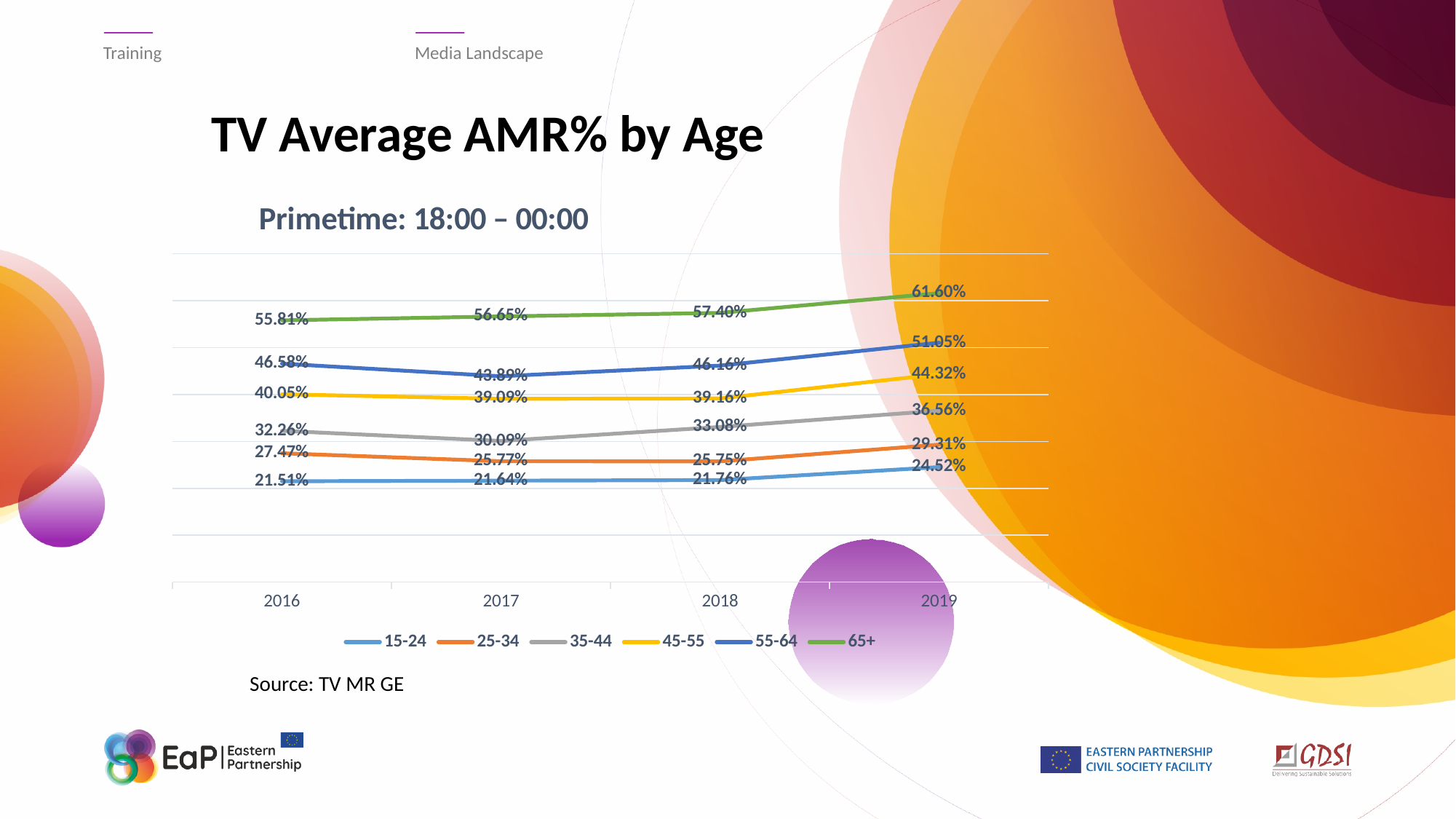
Does the 65+ series rise or fall from 2016 to 2019? rise What is the value for the 15-24 age group in 2016? 21.51% What kind of chart is shown on the slide? line chart How many years are shown on the x axis? 4 What is the difference between the 65+ value and the 15-24 value in 2019? 37.08% Which is larger in 2017: the 45-55 value or the 35-44 value? 45-55 Which age group has the highest value in 2019? 65+ Which age group has the lowest value in 2018? 15-24 What is the value for the 65+ age group in 2019? 61.60% What is the value for the 55-64 age group in 2017? 43.89% What is the title printed above the chart? Primetime: 18:00 – 00:00 How many series does the legend list? 6